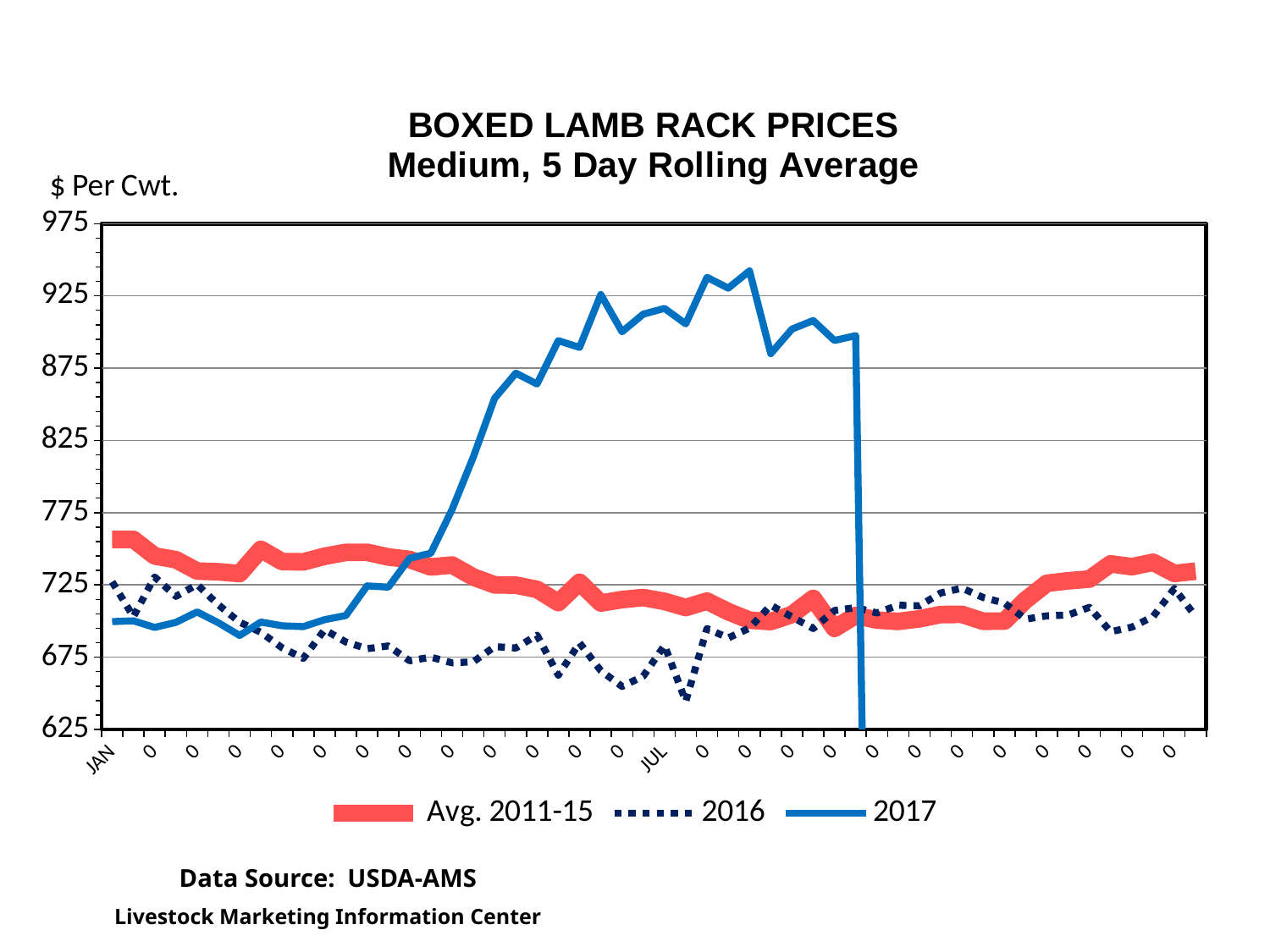
Is the highest value of the 2017 series greater or less than 925? greater Is the value of the 2017 series at JUL greater or less than 875? greater How many series does the legend list? 3 Is the value of the Avg. 2011-15 series at JAN greater or less than 775? less What is the title of the chart? BOXED LAMB RACK PRICES Medium, 5 Day Rolling Average Does the 2017 series rise or fall from JAN to JUL? rise What unit is shown on the vertical axis label? $ Per Cwt. What kind of chart is shown on the slide? line chart At JUL, which series has the higher value: 2017 or Avg. 2011-15? 2017 At JAN, which series has the higher value: Avg. 2011-15 or 2017? Avg. 2011-15